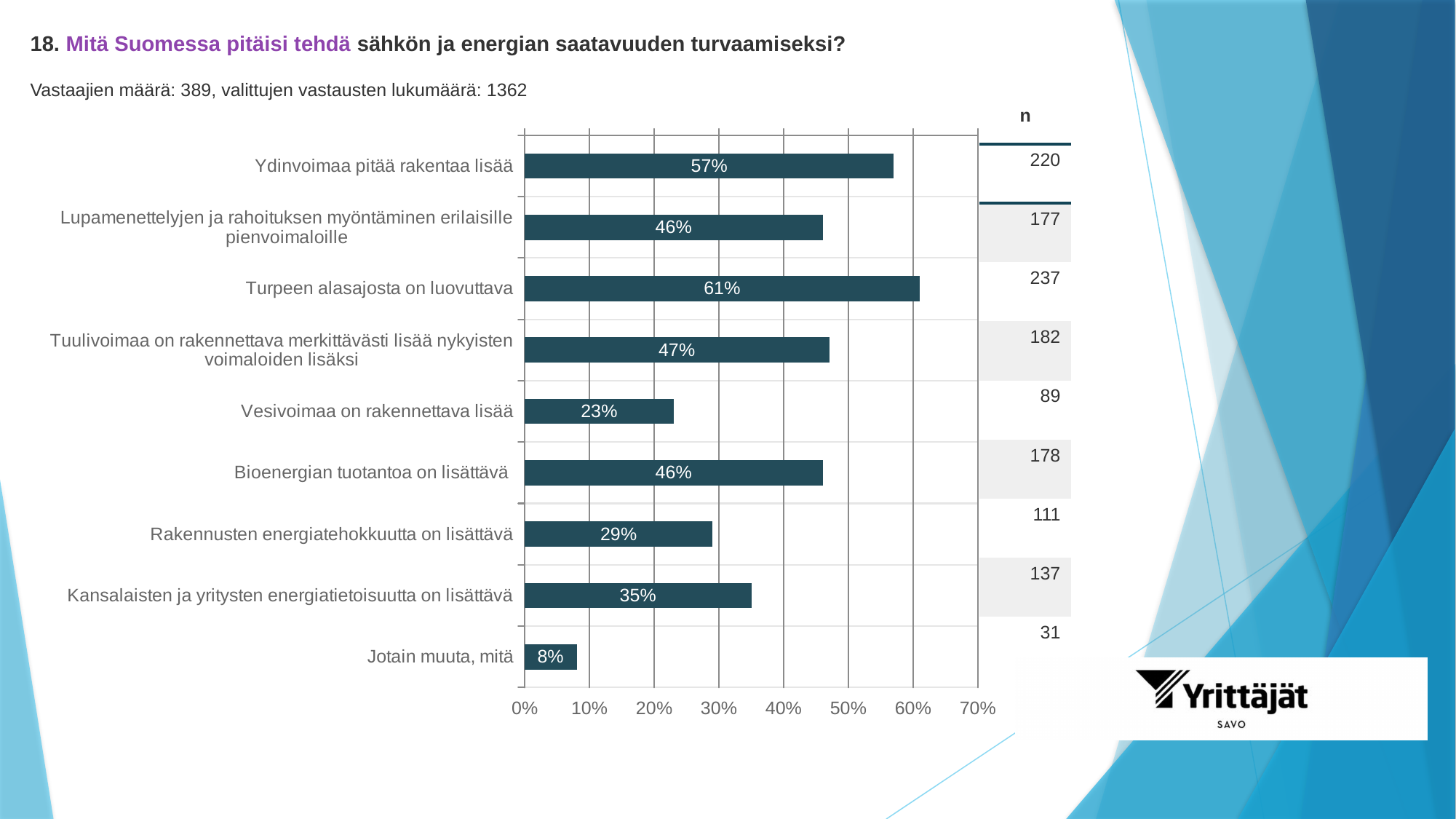
Is the value for "Tuulivoimaa on rakennettava merkittävästi lisää nykyisten voimaloiden lisäksi" greater or less than 40%? greater What percentage is shown for "Vesivoimaa on rakennettava lisää"? 23% What is the number of respondents (Vastaajien määrä) stated on the slide? 389 What kind of chart is shown on the slide? Bar chart Which category has the lowest percentage? Jotain muuta, mitä Which is larger: the percentage for "Rakennusten energiatehokkuutta on lisättävä" or for "Kansalaisten ja yritysten energiatietoisuutta on lisättävä"? Kansalaisten ja yritysten energiatietoisuutta on lisättävä What is the n value shown for "Jotain muuta, mitä"? 31 What percentage is shown for "Ydinvoimaa pitää rakentaa lisää"? 57% How many categories are shown in the chart? 9 What is the n value shown for "Turpeen alasajosta on luovuttava"? 237 What is the difference in percentage points between "Turpeen alasajosta on luovuttava" and "Ydinvoimaa pitää rakentaa lisää"? 4 Which category has the highest percentage? Turpeen alasajosta on luovuttava